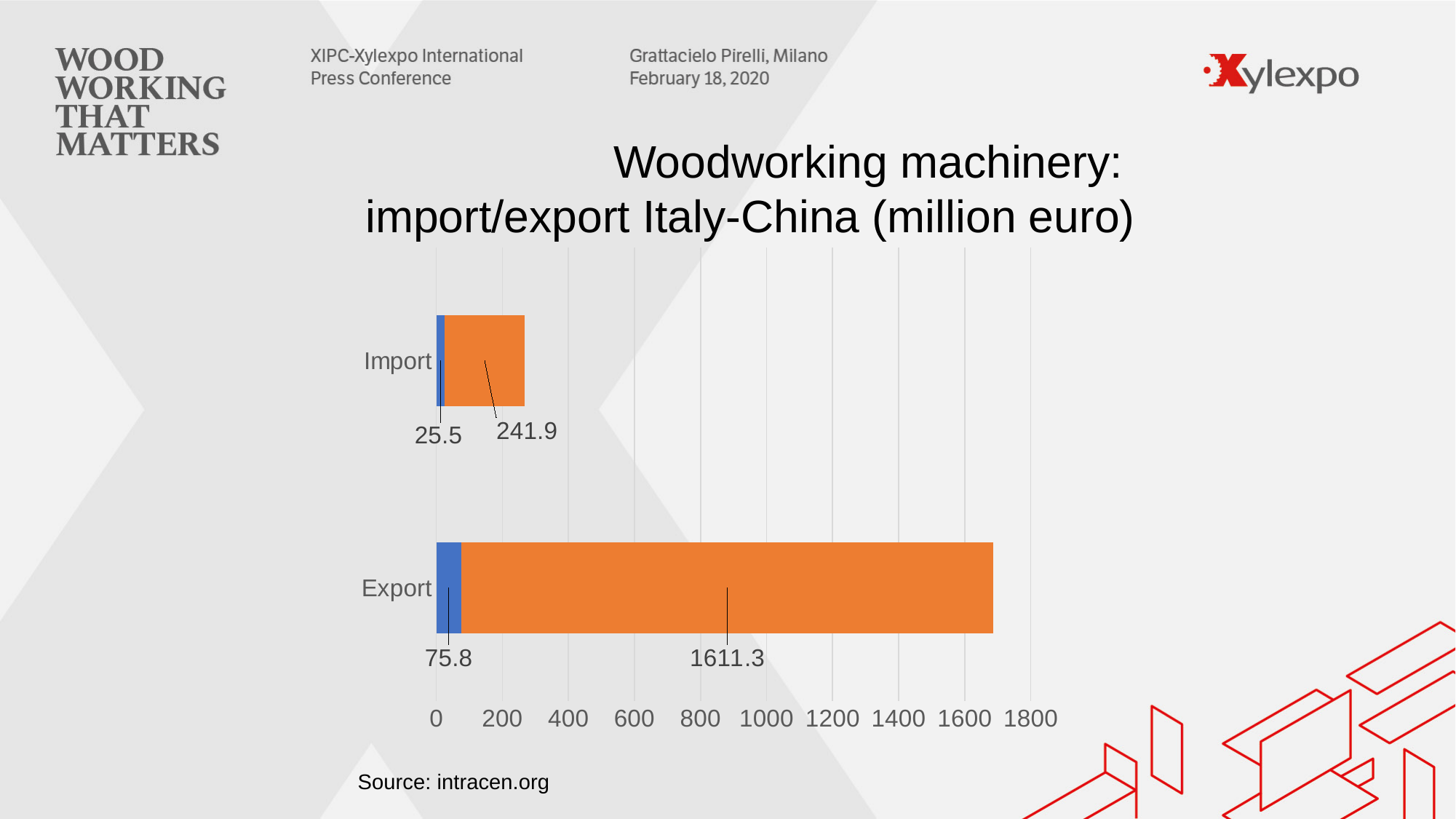
What is the total of the stacked bar for Import? 267.4 What is the difference between the blue segment values for Export and Import? 50.3 What is the value of the orange segment for Export? 1611.3 Which category has the longer total bar, Import or Export? Export What is the title of the chart? Woodworking machinery: import/export Italy-China (million euro) What kind of chart is shown on the slide? Stacked bar chart What is the total of the stacked bar for Export? 1687.1 How many categories are shown on the chart? 2 What is the value of the blue segment for Import? 25.5 What is the value of the orange segment for Import? 241.9 What is the value of the blue segment for Export? 75.8 What is the difference between the orange segment values for Export and Import? 1369.4